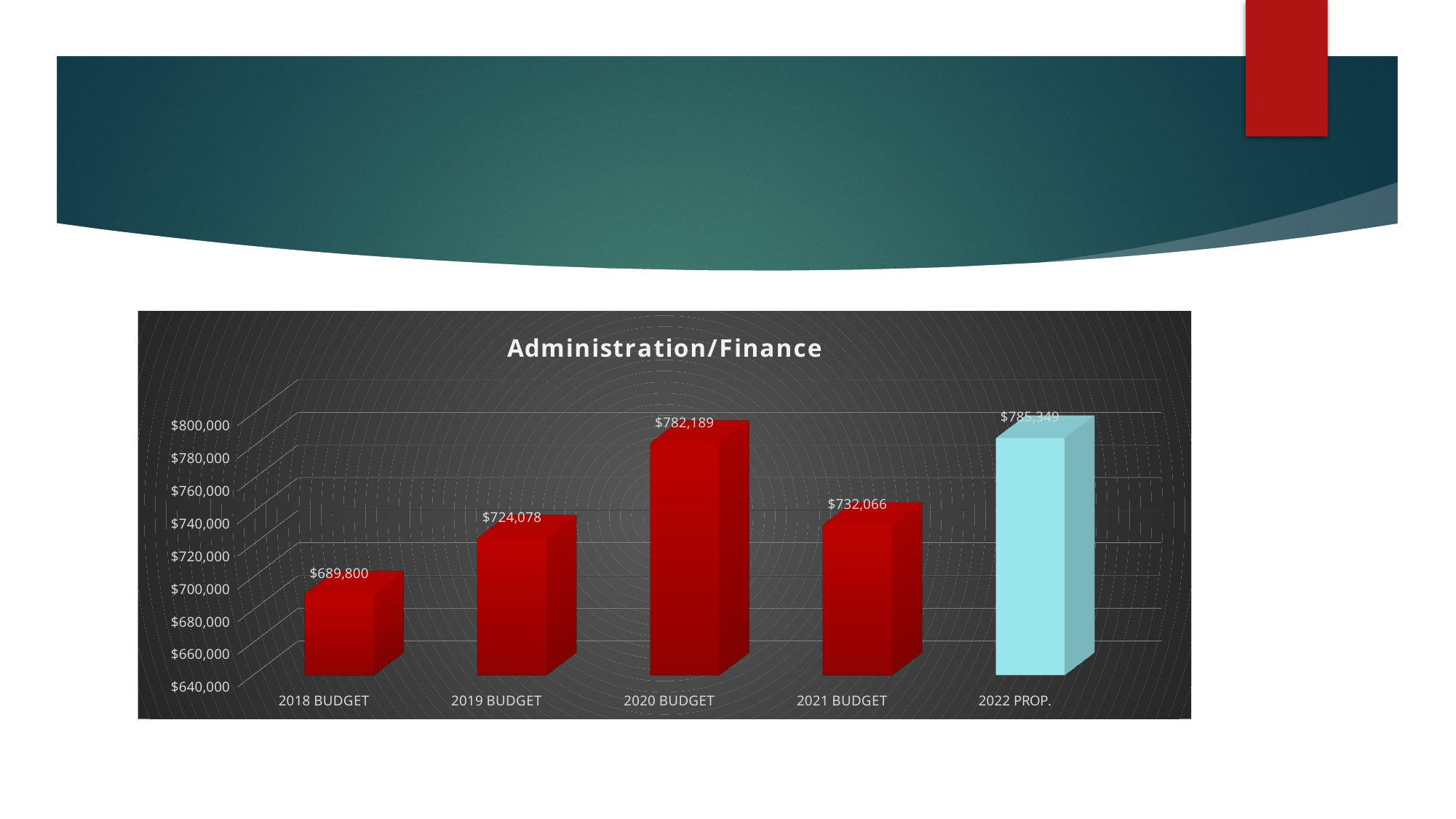
What is the value for 2022 PROP. in the Administration/Finance chart? $785,349 What is the value for 2018 BUDGET in the Administration/Finance chart? $689,800 Which category has the highest value in the Administration/Finance chart? 2022 PROP. What is the difference between the 2022 PROP. and 2021 BUDGET values in the Administration/Finance chart? $53,283 Which category has the lowest value in the Administration/Finance chart? 2018 BUDGET How many categories are shown in the Administration/Finance chart? 5 What is the difference between the 2020 BUDGET and 2019 BUDGET values in the Administration/Finance chart? $58,111 What kind of chart is the Administration/Finance chart? bar chart What is the value for 2021 BUDGET in the Administration/Finance chart? $732,066 Is the value for 2018 BUDGET greater or less than $700,000? less What is the value for 2020 BUDGET in the Administration/Finance chart? $782,189 Which is larger in the Administration/Finance chart, 2019 BUDGET or 2021 BUDGET? 2021 BUDGET